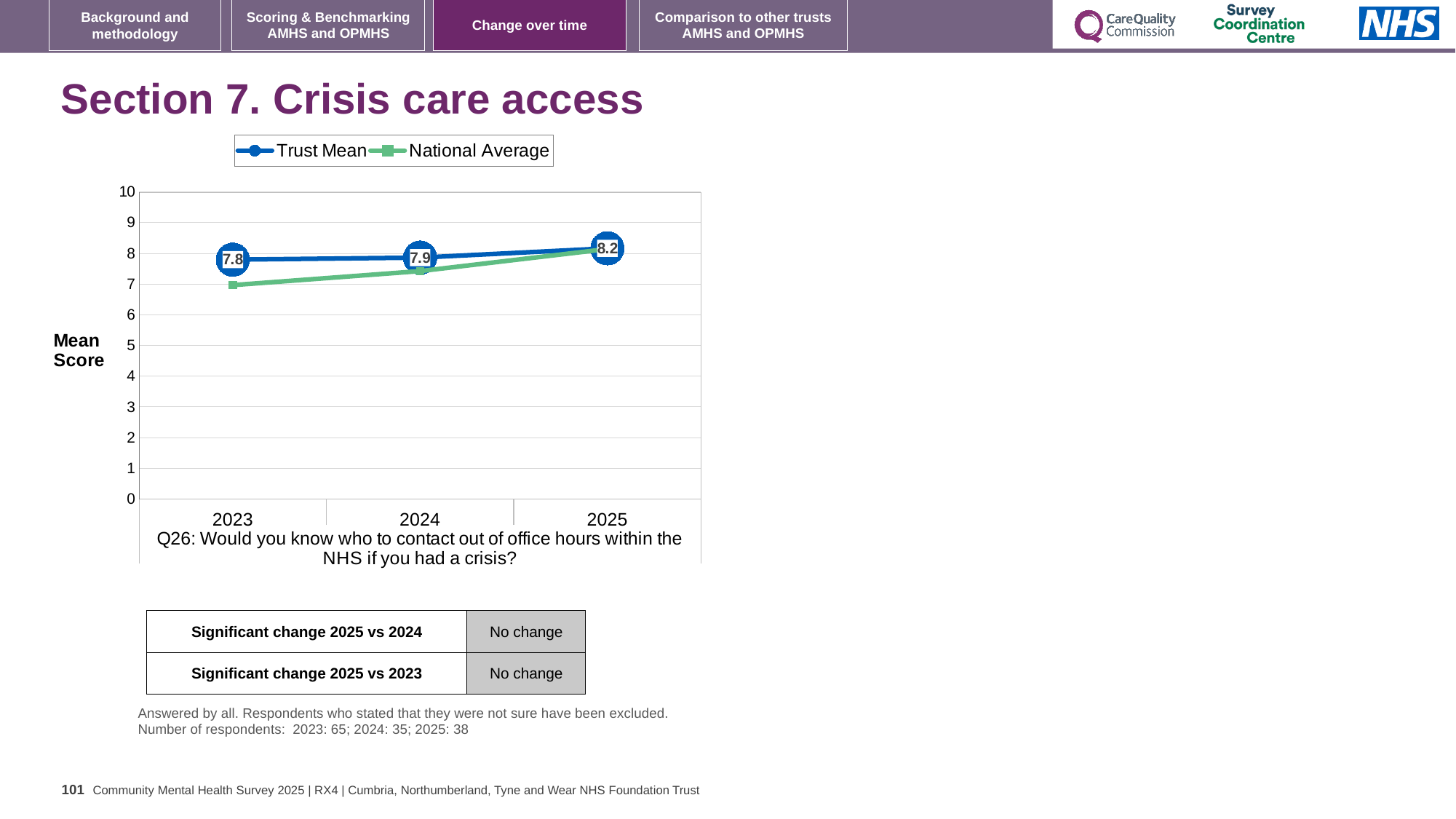
What is the difference between the Trust Mean in 2025 and in 2023? 0.4 What kind of chart is shown on the slide? Line chart In which year is the Trust Mean highest? 2025 How many series does the chart legend list? 2 In which year is the Trust Mean lowest? 2023 How many years are shown on the x axis of the chart? 3 Is the National Average value for 2025 greater or less than 7? greater Which is larger in 2023, the Trust Mean or the National Average? Trust Mean What is the Trust Mean value for 2025? 8.2 What is the Trust Mean value for 2024? 7.9 What is the Trust Mean value for 2023? 7.8